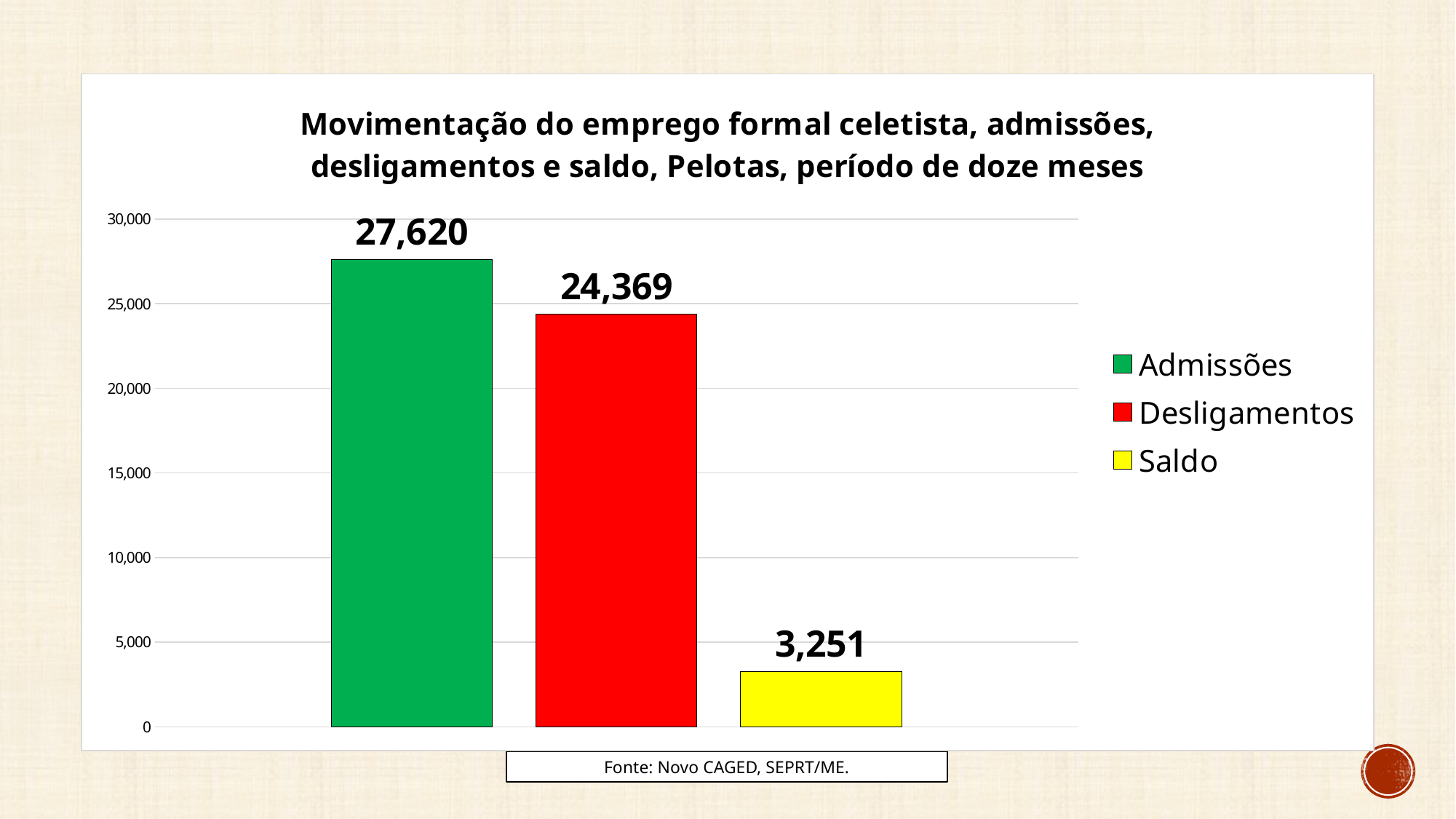
Is the value for Desligamentos greater or less than 25,000? less What kind of chart is shown on the slide? bar chart What is the value for Desligamentos? 24,369 How many bars are plotted in the chart? 3 Which series has the highest value? Admissões How many series does the legend list? 3 What is the value for Admissões? 27,620 What is the difference between Admissões and Desligamentos? 3,251 Which series has the lowest value? Saldo What is the value for Saldo? 3,251 Which is larger, Desligamentos or Saldo? Desligamentos What colour is the bar for Saldo? yellow